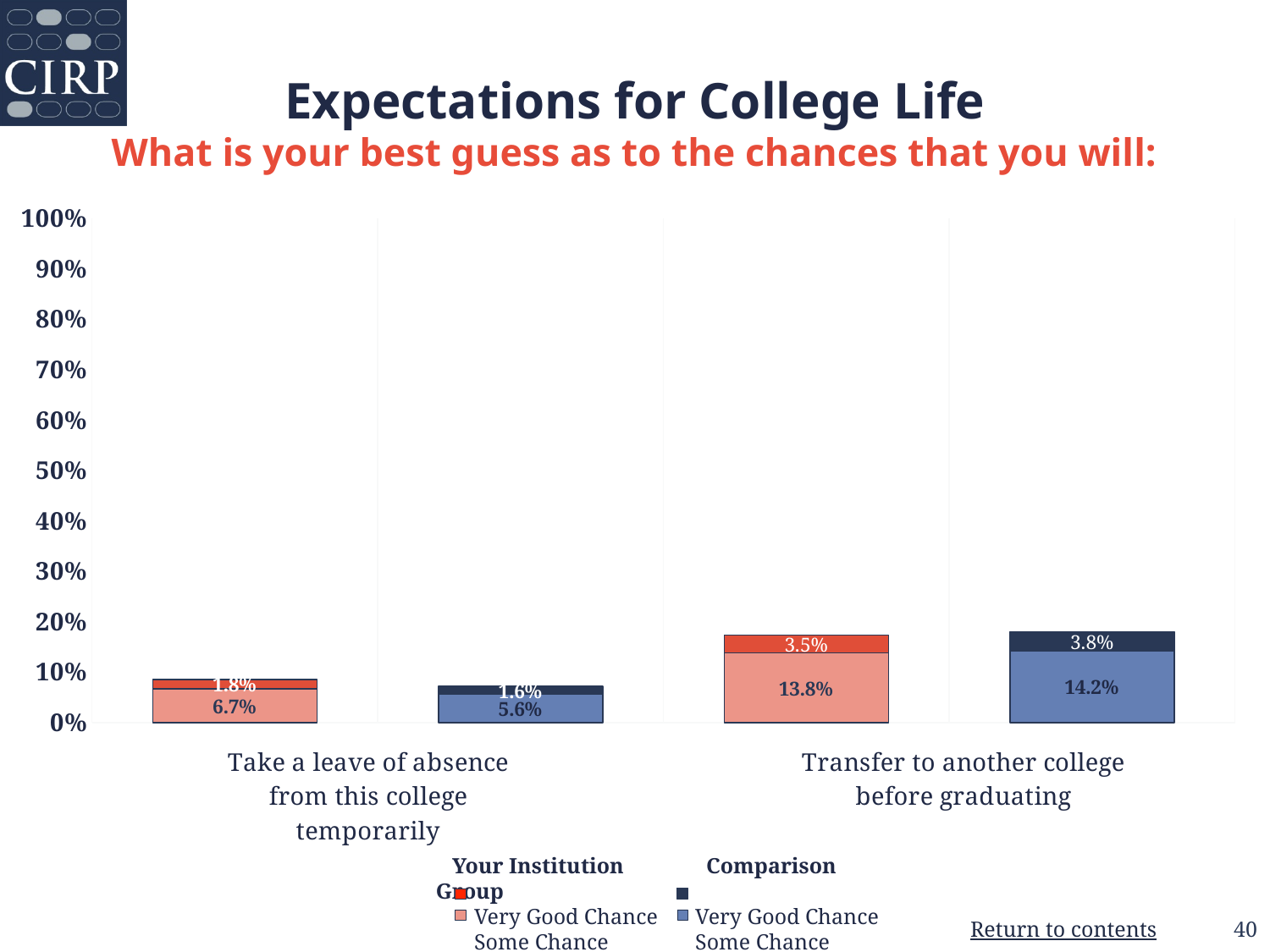
How many categories are shown on the x axis of the chart? 2 How many series does the chart legend list? 4 What is the total stacked value of the Comparison Group bar for 'Transfer to another college before graduating'? 18.0% What is the 'Some Chance' value for Your Institution for 'Transfer to another college before graduating'? 13.8% What is the difference between the Comparison Group and Your Institution 'Some Chance' values for 'Transfer to another college before graduating'? 0.4% What is the 'Some Chance' value for the Comparison Group for 'Transfer to another college before graduating'? 14.2% What is the 'Very Good Chance' value for the Comparison Group for 'Take a leave of absence from this college temporarily'? 1.6% What is the 'Very Good Chance' value for Your Institution for 'Take a leave of absence from this college temporarily'? 1.8% What type of chart is shown on the slide? Stacked bar chart What is the total stacked value of the Your Institution bar for 'Take a leave of absence from this college temporarily'? 8.5% For 'Take a leave of absence from this college temporarily', which has the larger 'Some Chance' value: Your Institution or the Comparison Group? Your Institution Is the total of the Comparison Group bar for 'Transfer to another college before graduating' greater or less than 10%? greater